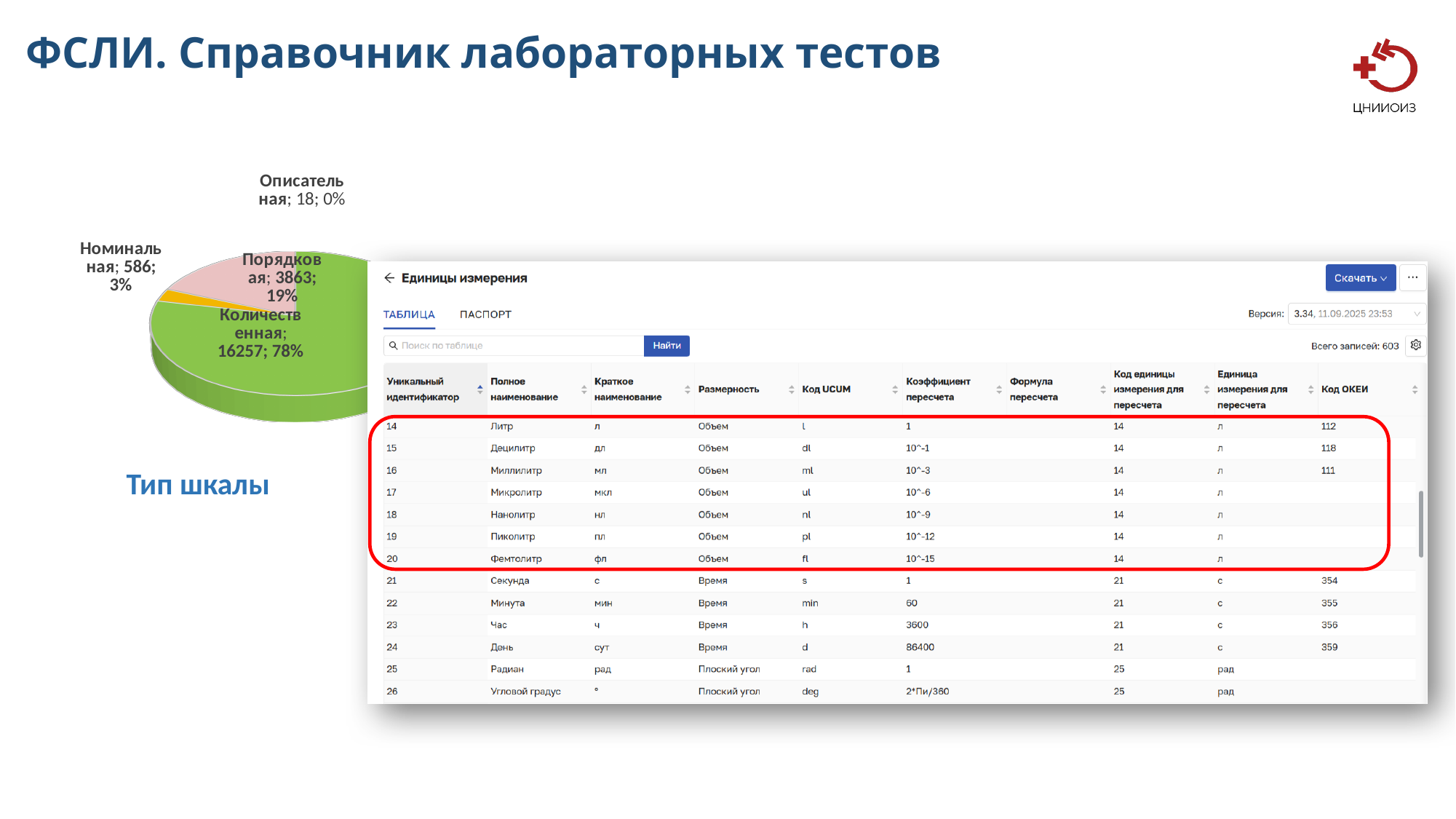
Which category is the largest in the "Тип шкалы" pie chart? Количественная In the "Тип шкалы" pie chart, what share does "Количественная" have? 78% Which category is the smallest in the "Тип шкалы" pie chart? Описательная In the "Тип шкалы" pie chart, what is the difference between the values for "Порядковая" and "Номинальная"? 3277 In the "Тип шкалы" pie chart, how many tests are in the "Количественная" category? 16257 In the "Тип шкалы" pie chart, which is larger: "Номинальная" or "Порядковая"? Порядковая In the "Тип шкалы" pie chart, what percentage is shown for "Описательная"? 0% What kind of chart is shown under the heading "Тип шкалы"? pie chart In the "Тип шкалы" pie chart, what is the value for "Порядковая"? 3863 In the "Тип шкалы" pie chart, what is the value for "Номинальная"? 586 How many categories does the "Тип шкалы" pie chart show? 4 In the "Тип шкалы" pie chart, what percentage is shown for "Порядковая"? 19%